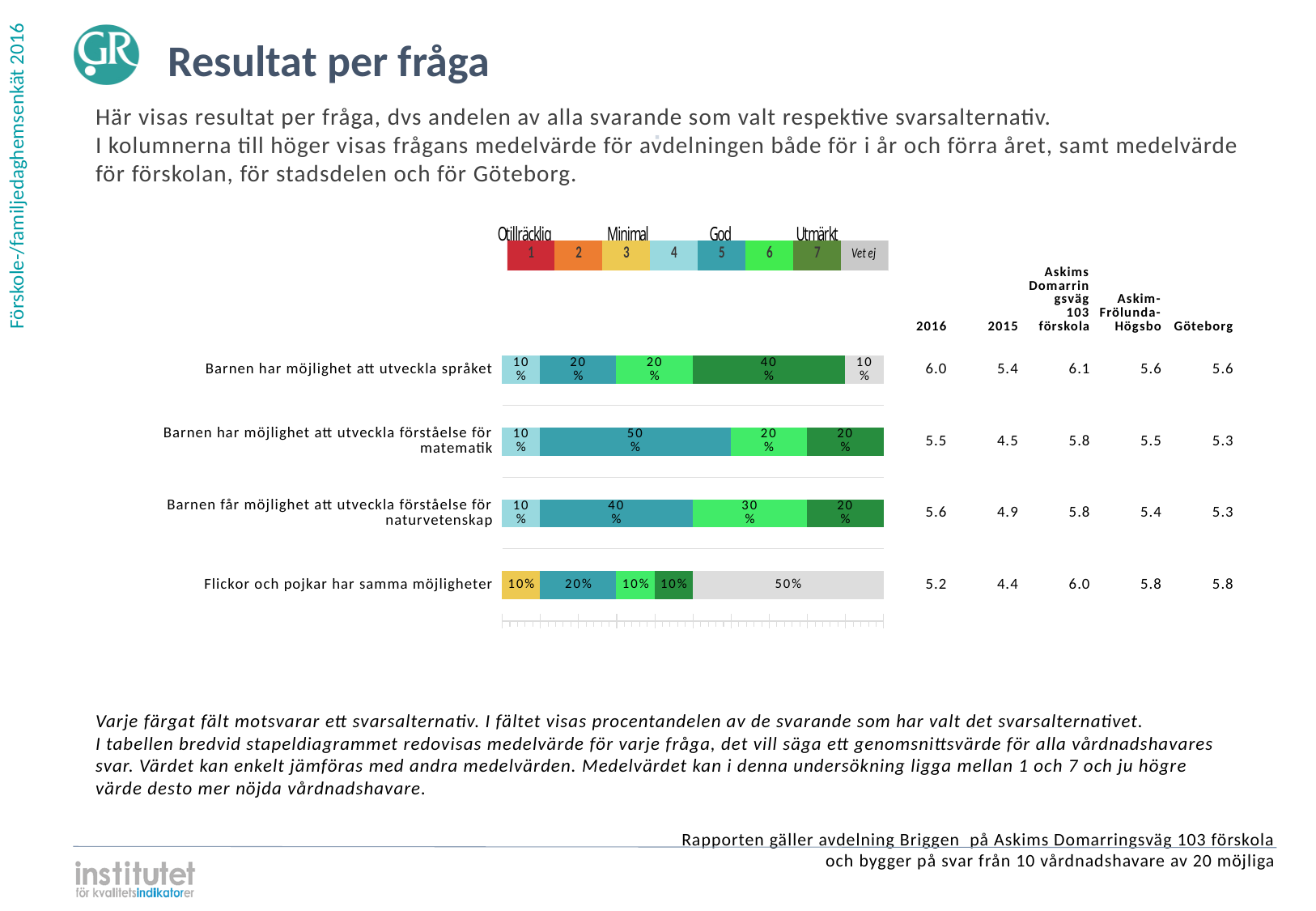
What is the difference between the option 6 share and the option 7 share for "Barnen får möjlighet att utveckla förståelse för naturvetenskap"? 10% How many response options does the legend above the chart list? 8 What percentage of respondents chose option 5 (teal) for "Barnen har möjlighet att utveckla förståelse för matematik"? 50% Which is larger for "Barnen har möjlighet att utveckla språket": the share for option 6 or the share for option 7? Option 7 What is the 2016 mean value shown for "Barnen har möjlighet att utveckla språket"? 6.0 What is the combined share of options 6 and 7 for "Barnen har möjlighet att utveckla förståelse för matematik"? 40% What percentage of respondents answered "Vet ej" for "Flickor och pojkar har samma möjligheter"? 50% What kind of chart is shown on the slide? Stacked bar chart What percentage of respondents chose option 7 (dark green) for "Barnen har möjlighet att utveckla språket"? 40% Which response option has the largest share for "Barnen får möjlighet att utveckla förståelse för naturvetenskap"? 5 How many questions (categories) are plotted in the bar chart? 4 Which question has the lowest 2015 mean value in the table next to the chart? Flickor och pojkar har samma möjligheter